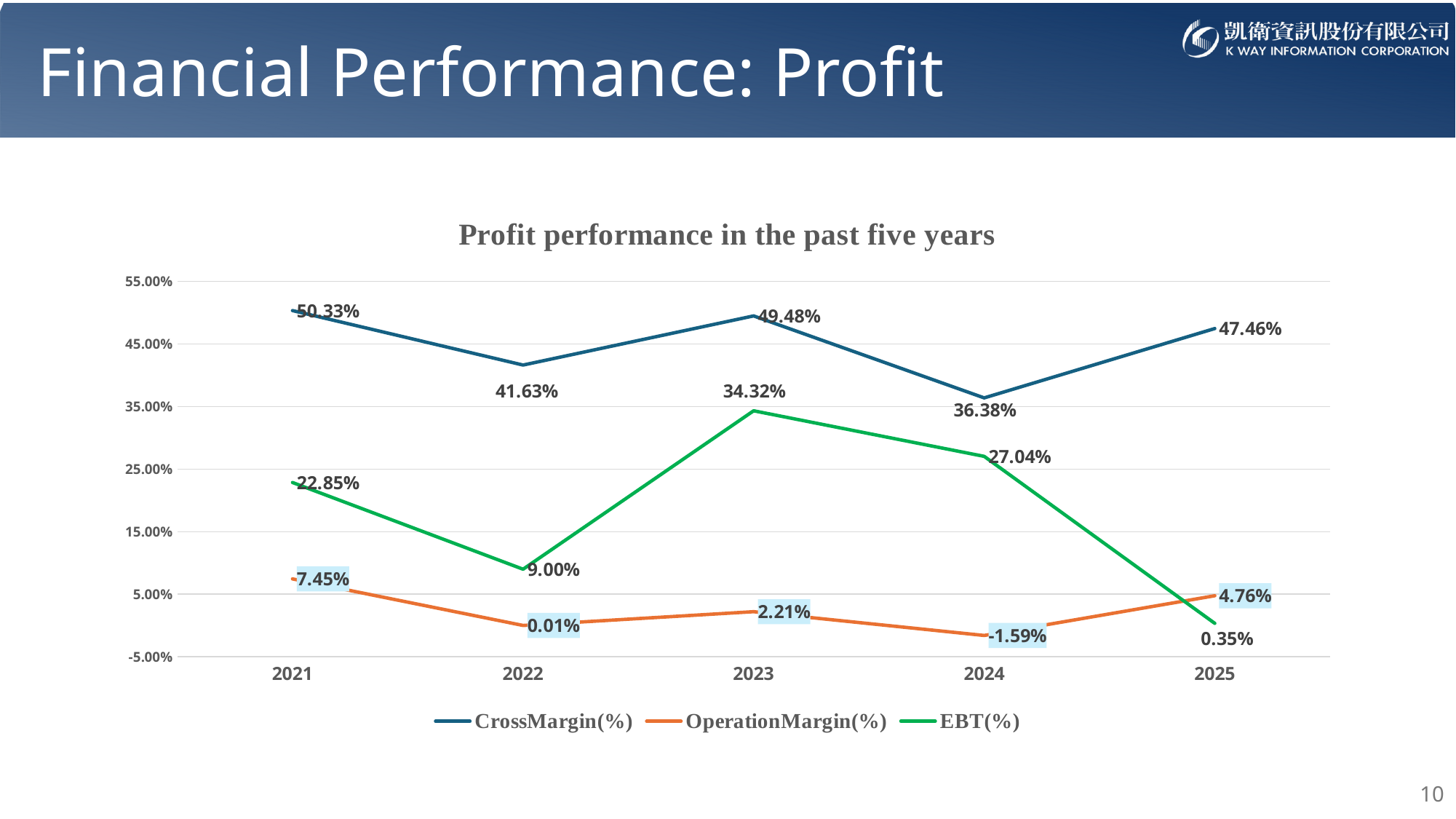
What is the title of the chart? Profit performance in the past five years In which year is EBT(%) highest? 2023 Does EBT(%) rise or fall from 2023 to 2025? Fall How many series does the legend list? 3 What is the CrossMargin(%) value for 2021? 50.33% What is the EBT(%) value for 2023? 34.32% How many years are shown on the x axis? 5 In which year is CrossMargin(%) lowest? 2024 What is the difference between the CrossMargin(%) values for 2021 and 2022? 8.70% What kind of chart is shown on the slide? Line chart What is the OperationMargin(%) value for 2024? -1.59% Which is larger in 2025, OperationMargin(%) or EBT(%)? OperationMargin(%)